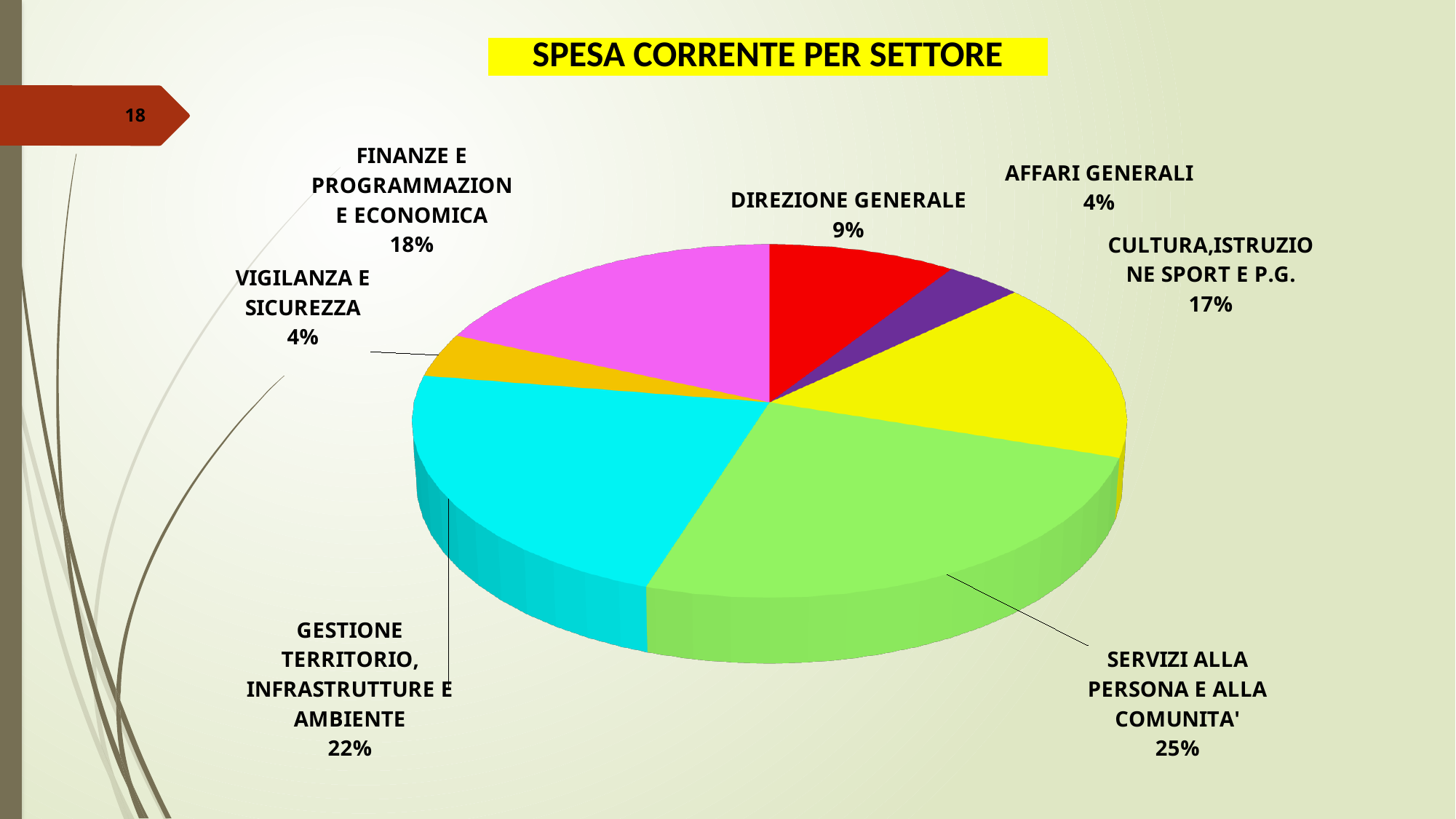
What is the title of the chart? SPESA CORRENTE PER SETTORE What percentage is shown for CULTURA,ISTRUZIONE SPORT E P.G.? 17% Which sector has the largest share of the pie? SERVIZI ALLA PERSONA E ALLA COMUNITA' What percentage is shown for GESTIONE TERRITORIO, INFRASTRUTTURE E AMBIENTE? 22% What type of chart is shown on the slide? pie chart What is the difference in percentage points between SERVIZI ALLA PERSONA E ALLA COMUNITA' and GESTIONE TERRITORIO, INFRASTRUTTURE E AMBIENTE? 3 How many slices does the pie chart have? 7 What share of the pie is SERVIZI ALLA PERSONA E ALLA COMUNITA'? 25% What colour is the slice for DIREZIONE GENERALE? red What percentage is shown for DIREZIONE GENERALE? 9% Which two sectors share the smallest percentage in the pie chart? AFFARI GENERALI and VIGILANZA E SICUREZZA Which is larger, FINANZE E PROGRAMMAZIONE ECONOMICA or CULTURA,ISTRUZIONE SPORT E P.G.? FINANZE E PROGRAMMAZIONE ECONOMICA